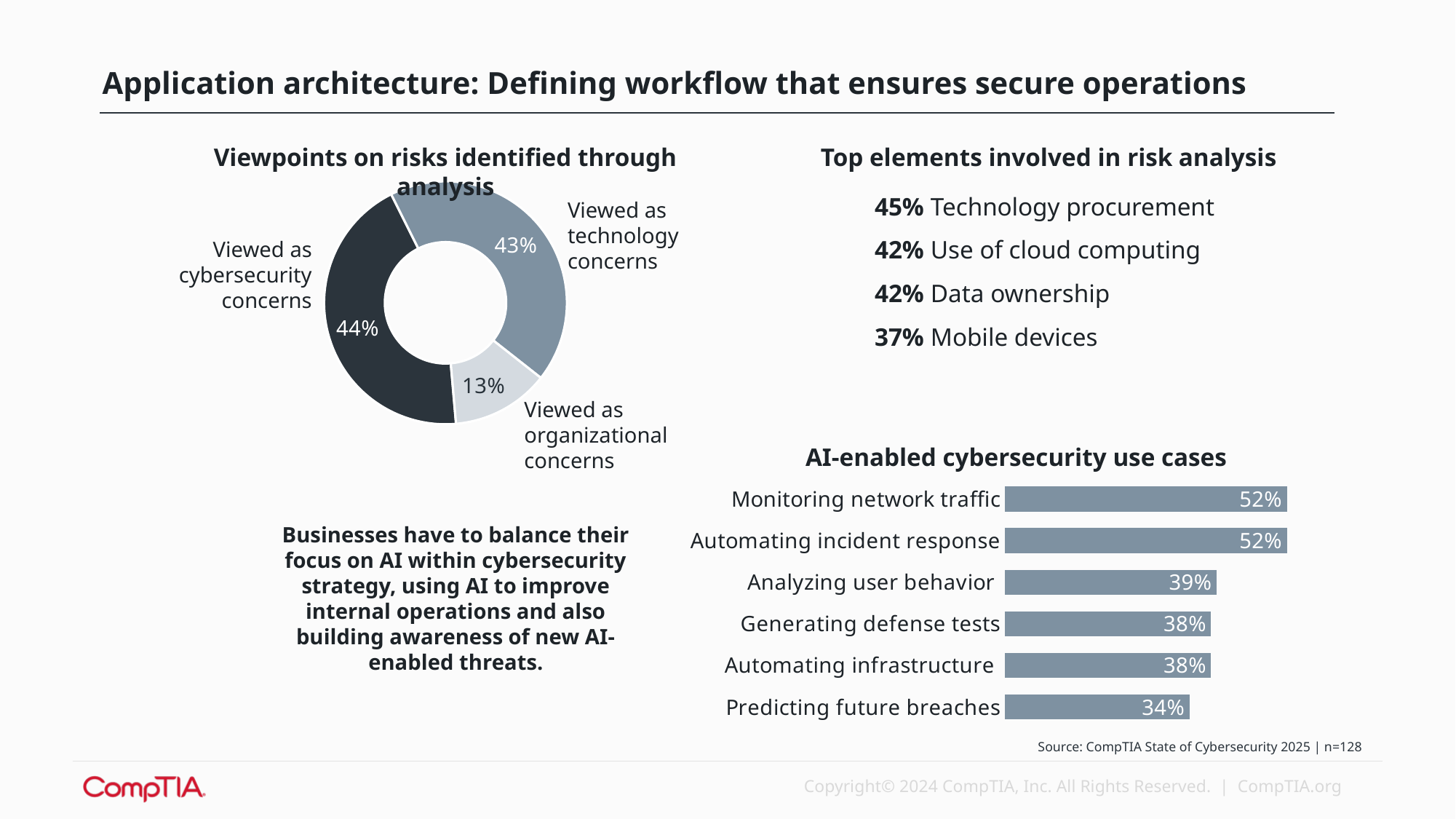
In the 'AI-enabled cybersecurity use cases' chart, what is the difference between Monitoring network traffic and Generating defense tests? 14 percentage points What kind of chart is 'Viewpoints on risks identified through analysis'? Donut (pie) chart In the 'Viewpoints on risks identified through analysis' chart, which viewpoint has the smallest share? Viewed as organizational concerns In the 'AI-enabled cybersecurity use cases' chart, what is the value for Analyzing user behavior? 39% In the 'AI-enabled cybersecurity use cases' chart, how many use cases are listed? 6 In the 'AI-enabled cybersecurity use cases' chart, which use case has the lowest value? Predicting future breaches In the 'AI-enabled cybersecurity use cases' chart, what is the value for Predicting future breaches? 34% What kind of chart is 'AI-enabled cybersecurity use cases'? Bar chart In the 'Viewpoints on risks identified through analysis' chart, what is the difference between the share viewed as technology concerns and the share viewed as organizational concerns? 30 percentage points In the 'Viewpoints on risks identified through analysis' chart, what share of respondents viewed risks as organizational concerns? 13% In the 'Viewpoints on risks identified through analysis' chart, how many slices does the donut have? 3 In the 'Viewpoints on risks identified through analysis' chart, what share of respondents viewed risks as cybersecurity concerns? 44%